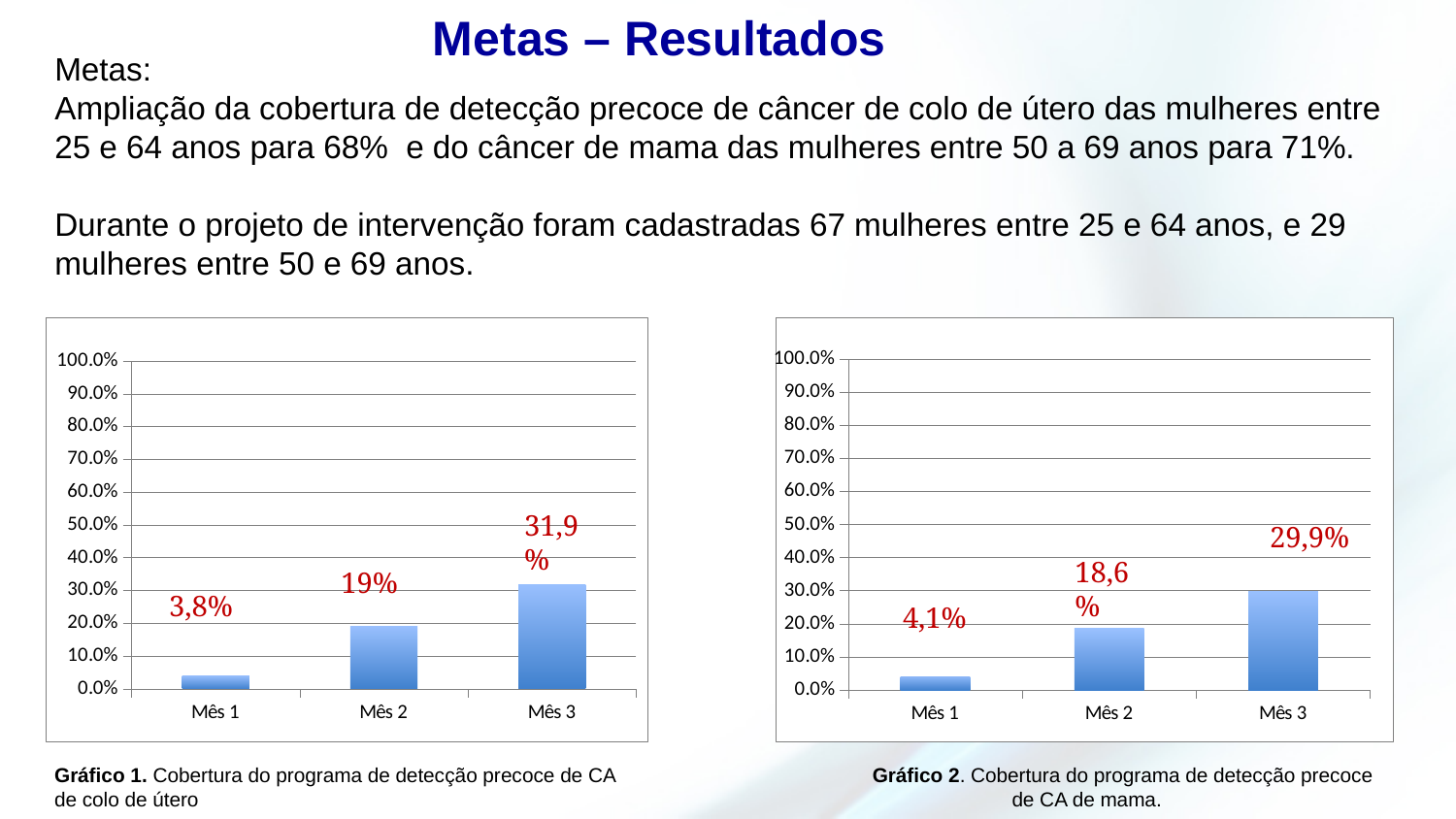
How many months (categories) are shown in Gráfico 1 (left chart)? 3 In Gráfico 1 (left chart), what is the value for Mês 2? 19% In Gráfico 2 (right chart), what is the value for Mês 3? 29,9% In Gráfico 2 (right chart), what is the value for Mês 1? 4,1% In Gráfico 1 (left chart), what is the difference between the values for Mês 3 and Mês 1? 28,1% Do the values in Gráfico 2 (right chart) rise or fall from Mês 1 to Mês 3? rise In Gráfico 2 (right chart), what is the difference between the values for Mês 3 and Mês 2? 11,3% Which is larger: the Mês 2 value in Gráfico 1 (left chart) or the Mês 2 value in Gráfico 2 (right chart)? Gráfico 1 (19%) In Gráfico 1 (left chart), which month has the lowest value? Mês 1 In Gráfico 2 (right chart), is the value for Mês 3 greater or less than 40.0%? less In Gráfico 1 (left chart), what is the value for Mês 3? 31,9% In Gráfico 2 (right chart), which month has the highest value? Mês 3